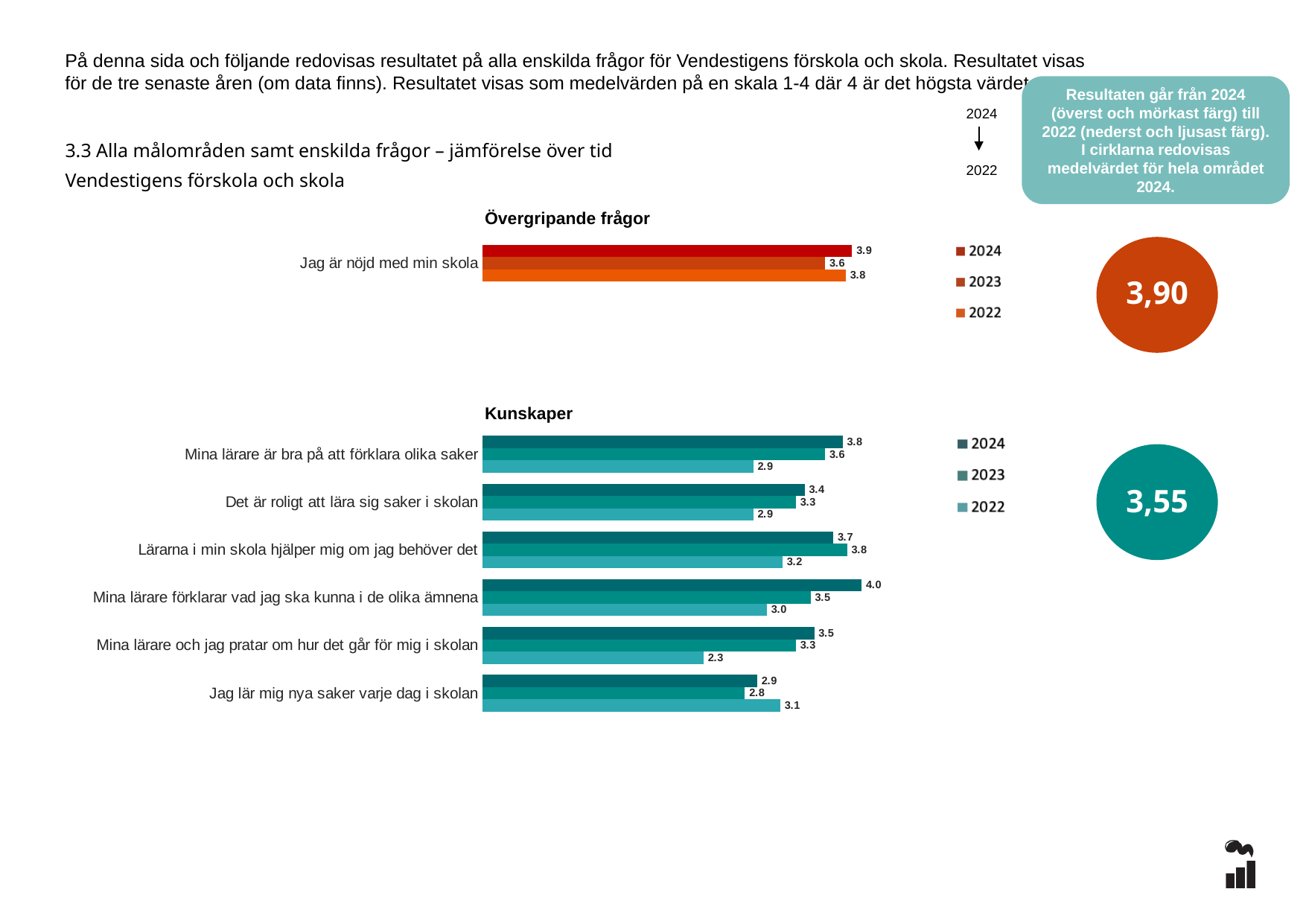
In the 'Kunskaper' chart, what is the difference between the 2024 and 2022 values for 'Mina lärare är bra på att förklara olika saker'? 0.9 In the 'Kunskaper' chart, what is the 2022 value for 'Mina lärare och jag pratar om hur det går för mig i skolan'? 2.3 What kind of chart is the 'Kunskaper' chart? Bar chart In the 'Kunskaper' chart, which is larger for 'Lärarna i min skola hjälper mig om jag behöver det': the 2024 value or the 2023 value? 2023 In the 'Övergripande frågor' chart, what is the 2024 value for 'Jag är nöjd med min skola'? 3.9 What value is shown in the circle next to the 'Kunskaper' chart? 3,55 In the 'Kunskaper' chart, what is the 2024 value for 'Mina lärare förklarar vad jag ska kunna i de olika ämnena'? 4.0 In the 'Övergripande frågor' chart, how many series does the legend list? 3 How many questions (categories) are shown in the 'Kunskaper' chart? 6 In the 'Övergripande frågor' chart, what is the 2022 value for 'Jag är nöjd med min skola'? 3.8 In the 'Kunskaper' chart, which question has the lowest 2022 value? Mina lärare och jag pratar om hur det går för mig i skolan In the 'Kunskaper' chart, which question has the highest 2024 value? Mina lärare förklarar vad jag ska kunna i de olika ämnena